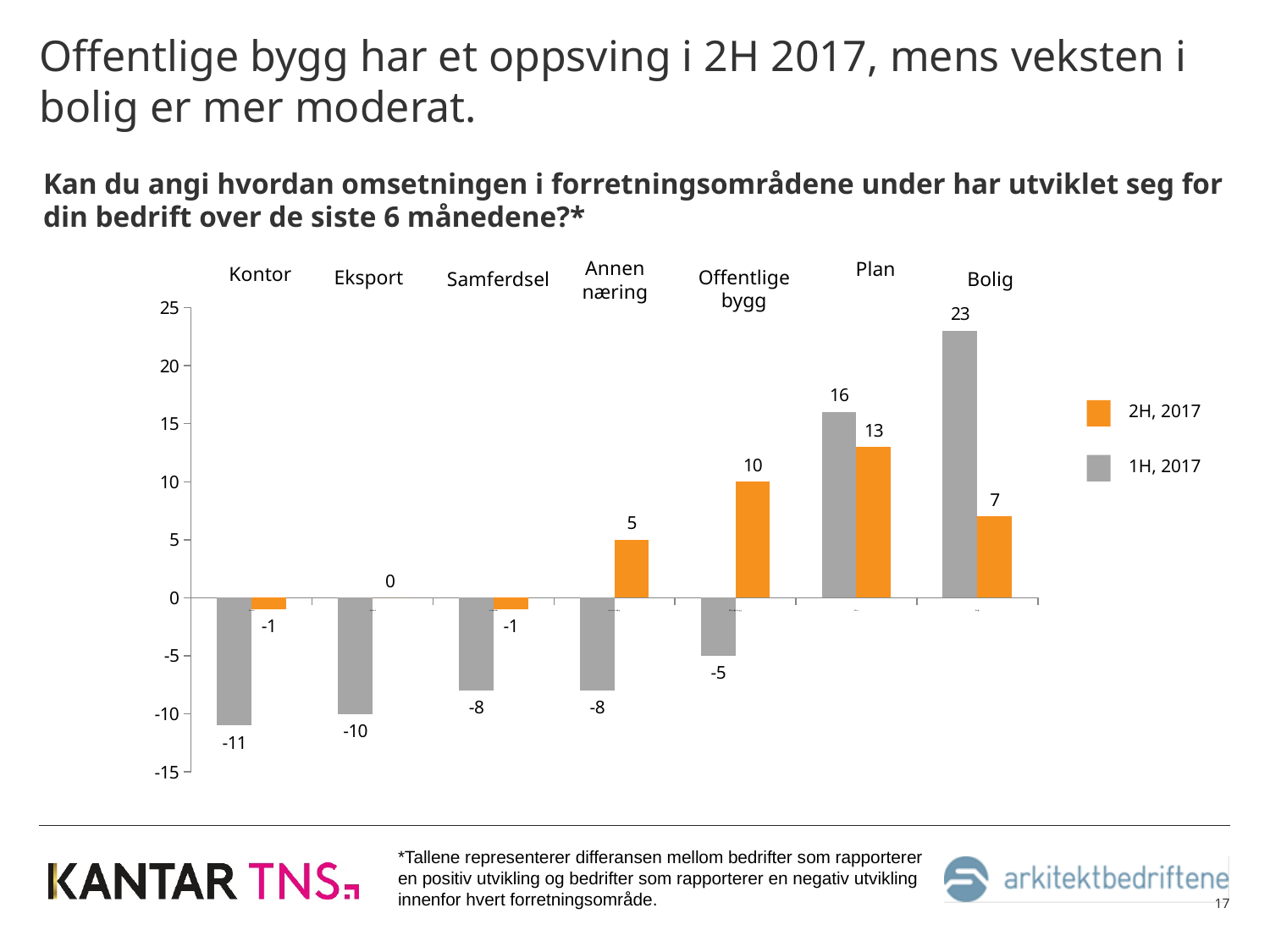
Which category has the highest value in the 2H, 2017 series? Plan Which category has the lowest value in the 1H, 2017 series? Kontor What is the value for Bolig in the 1H, 2017 series? 23 Which is larger for Plan: the 1H, 2017 value or the 2H, 2017 value? 1H, 2017 How many series does the legend list? 2 What is the value for Kontor in the 1H, 2017 series? -11 How many categories are shown on the x axis? 7 What kind of chart is shown on the slide? Bar chart What is the difference between the 2H, 2017 and 1H, 2017 values for Offentlige bygg? 15 What is the value for Eksport in the 2H, 2017 series? 0 What is the value for Offentlige bygg in the 2H, 2017 series? 10 Which colour represents the 2H, 2017 series? Orange